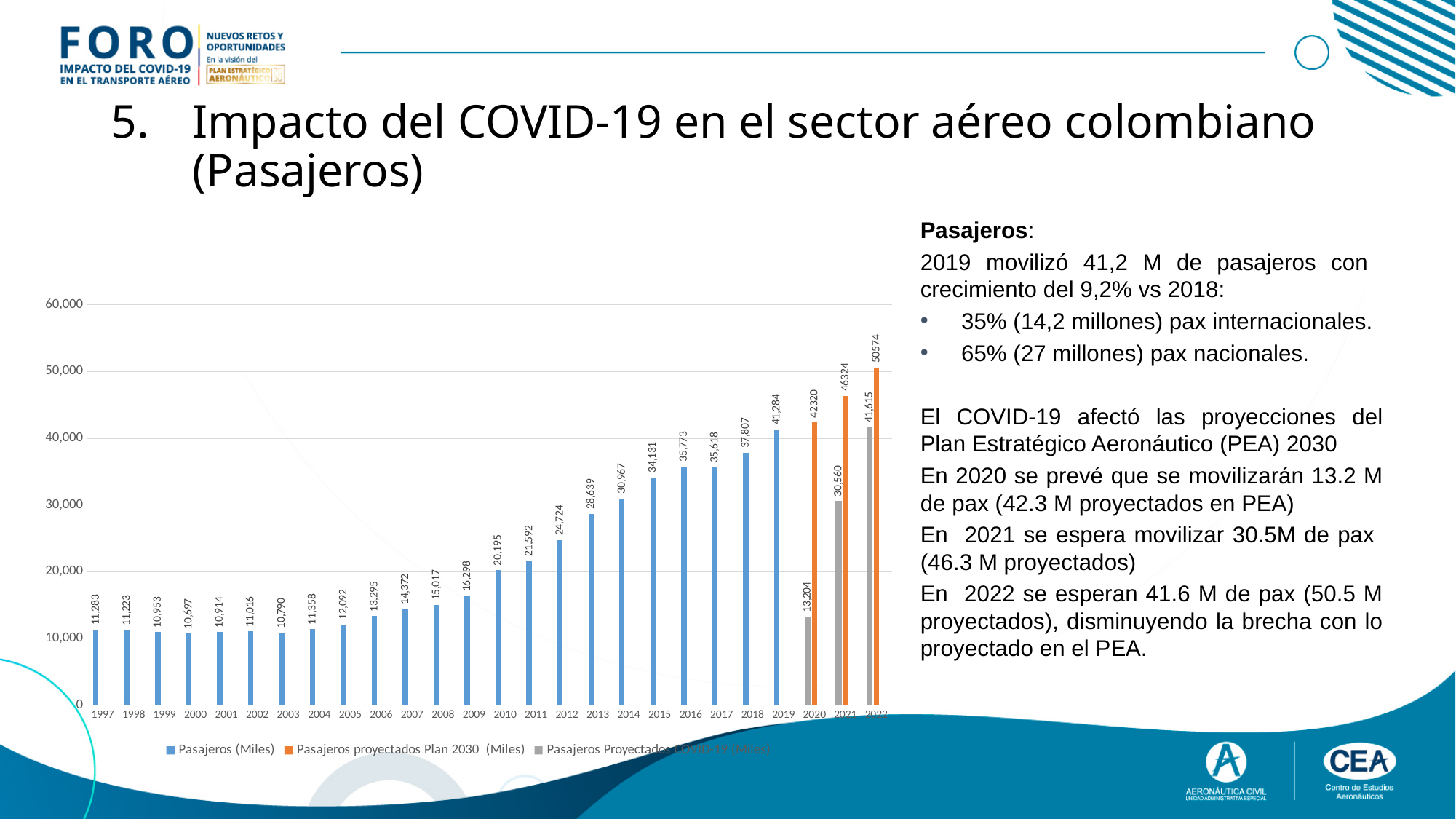
What is the value of Pasajeros (Miles) for 2019? 41,284 What kind of chart is shown on the slide? Bar chart What is the difference between Pasajeros (Miles) in 2019 and 2018? 3,477 Which year has the lowest value in the Pasajeros (Miles) series? 2000 Which year has the highest value in the Pasajeros (Miles) series? 2019 How many series does the legend list? 3 What is the difference between the Plan 2030 projection and the COVID-19 projection for 2022? 8,959 How many years are shown on the x axis of the chart? 26 What is the value of Pasajeros proyectados Plan 2030 (Miles) for 2020? 42320 Does the Pasajeros (Miles) series rise or fall from 2004 to 2019? Rise Which is larger, Pasajeros (Miles) in 2016 or in 2017? 2016 What is the value of Pasajeros Proyectados COVID-19 (Miles) for 2021? 30,560